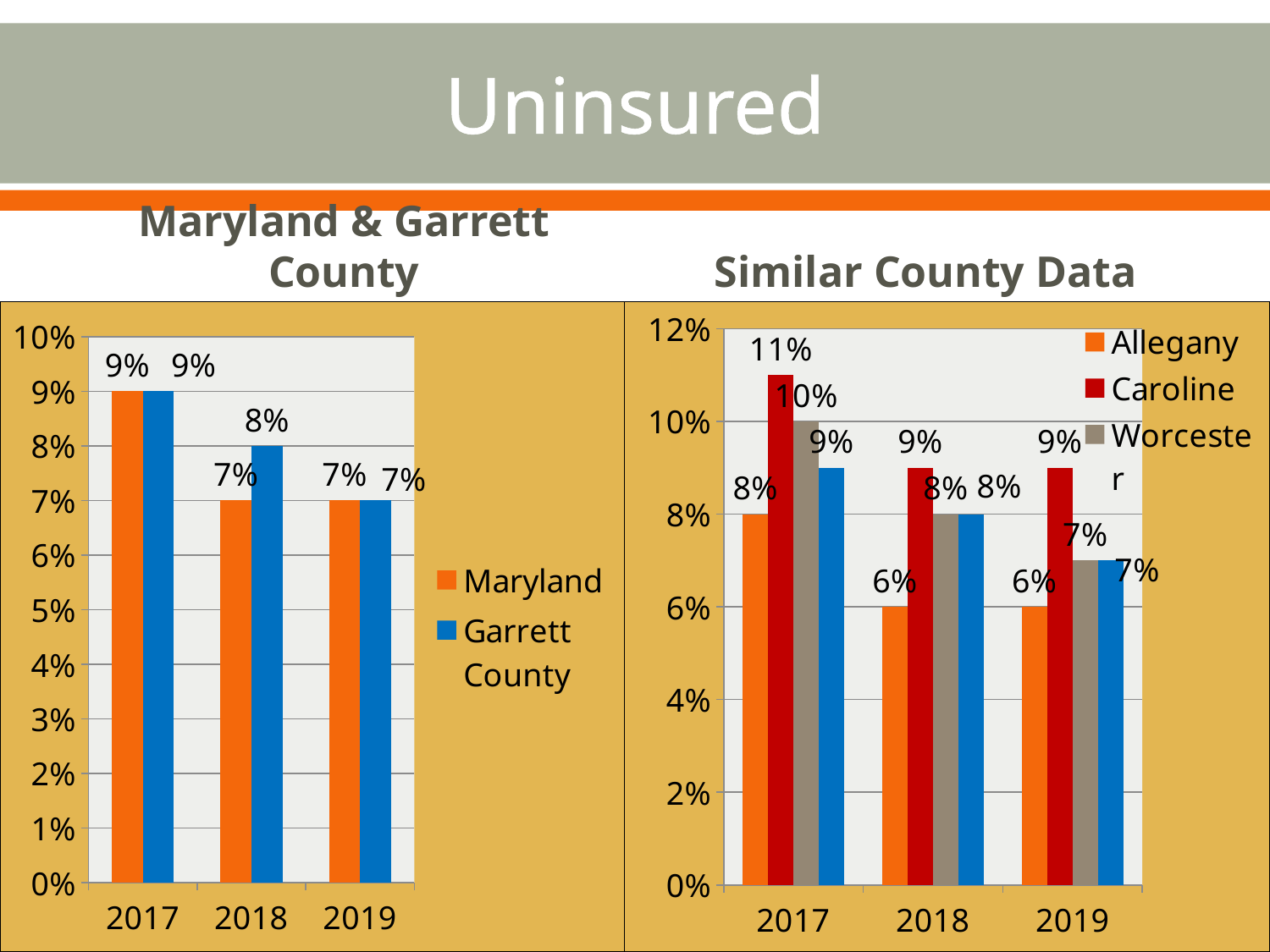
In the 'Maryland & Garrett County' chart, in which year is the Garrett County value highest? 2017 In the 'Similar County Data' chart, what is the value for Worcester in 2019? 7% In the 'Maryland & Garrett County' chart, do the Maryland values rise or fall from 2017 to 2019? fall In the 'Similar County Data' chart, what is the difference between the Caroline and Allegany values in 2018? 3 percentage points In the 'Similar County Data' chart, which county has the highest value in 2017? Caroline What kind of chart is the 'Maryland & Garrett County' chart? bar chart In the 'Maryland & Garrett County' chart, what is the value for Maryland in 2018? 7% How many years are shown on the x axis of the 'Similar County Data' chart? 3 In the 'Similar County Data' chart, what is the value for Allegany in 2018? 6% In the 'Similar County Data' chart, what is the value for Caroline in 2017? 11% How many series does the legend of the 'Maryland & Garrett County' chart list? 2 In the 'Maryland & Garrett County' chart, what is the value for Garrett County in 2018? 8%